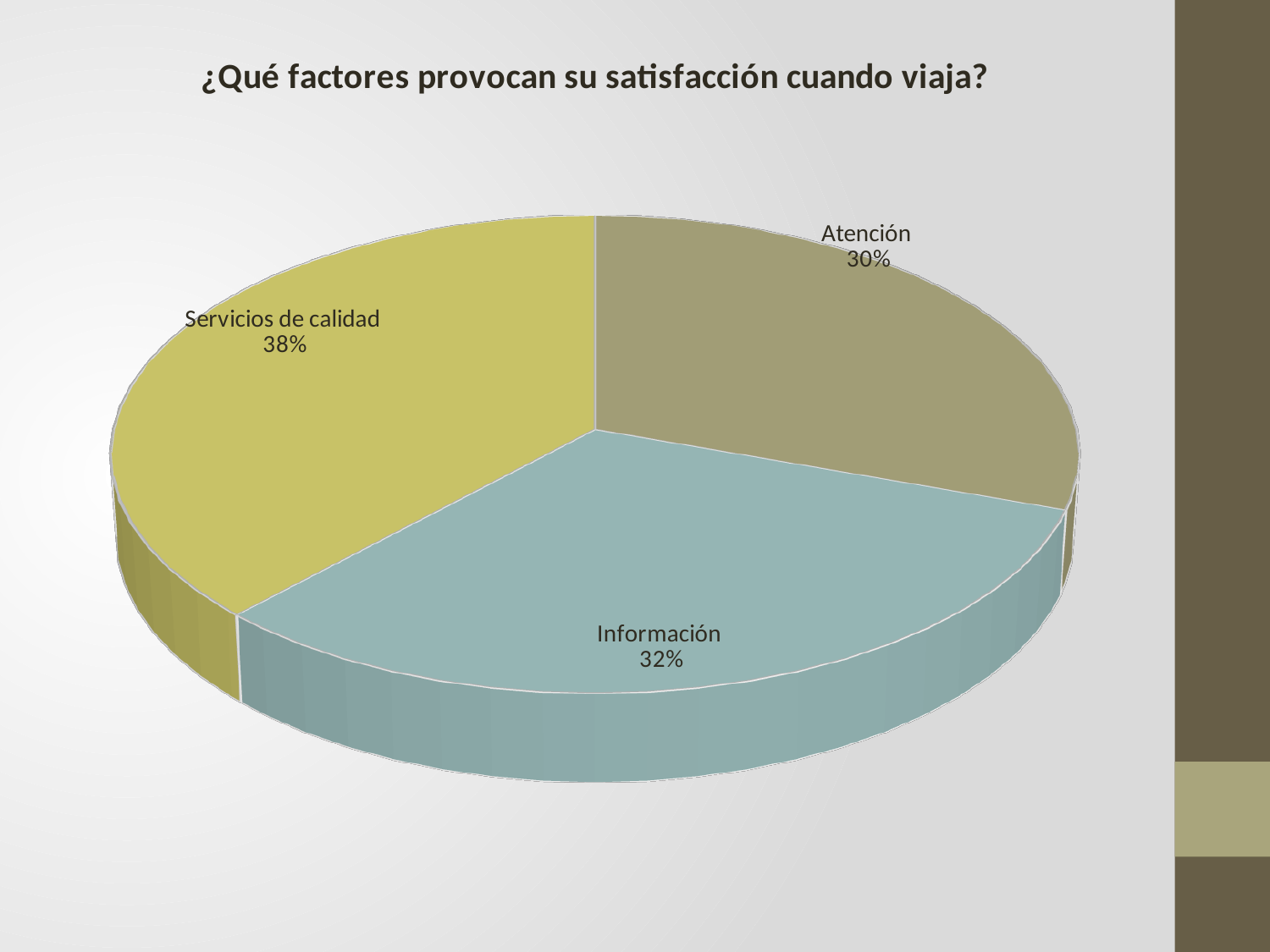
Which is larger, the share for Servicios de calidad or the share for Información? Servicios de calidad What is the difference in percentage points between Información and Atención? 2 How many slices does the pie chart have? 3 Which factor has the largest share of the pie? Servicios de calidad What type of chart is shown on the slide? Pie chart What percentage is shown for Servicios de calidad? 38% What percentage is shown for Información? 32% Which factor has the smallest share of the pie? Atención What is the title of the chart? ¿Qué factores provocan su satisfacción cuando viaja? What colour is the Información slice? Blue-grey (teal) What percentage is shown for Atención? 30% What is the difference in percentage points between Servicios de calidad and Atención? 8